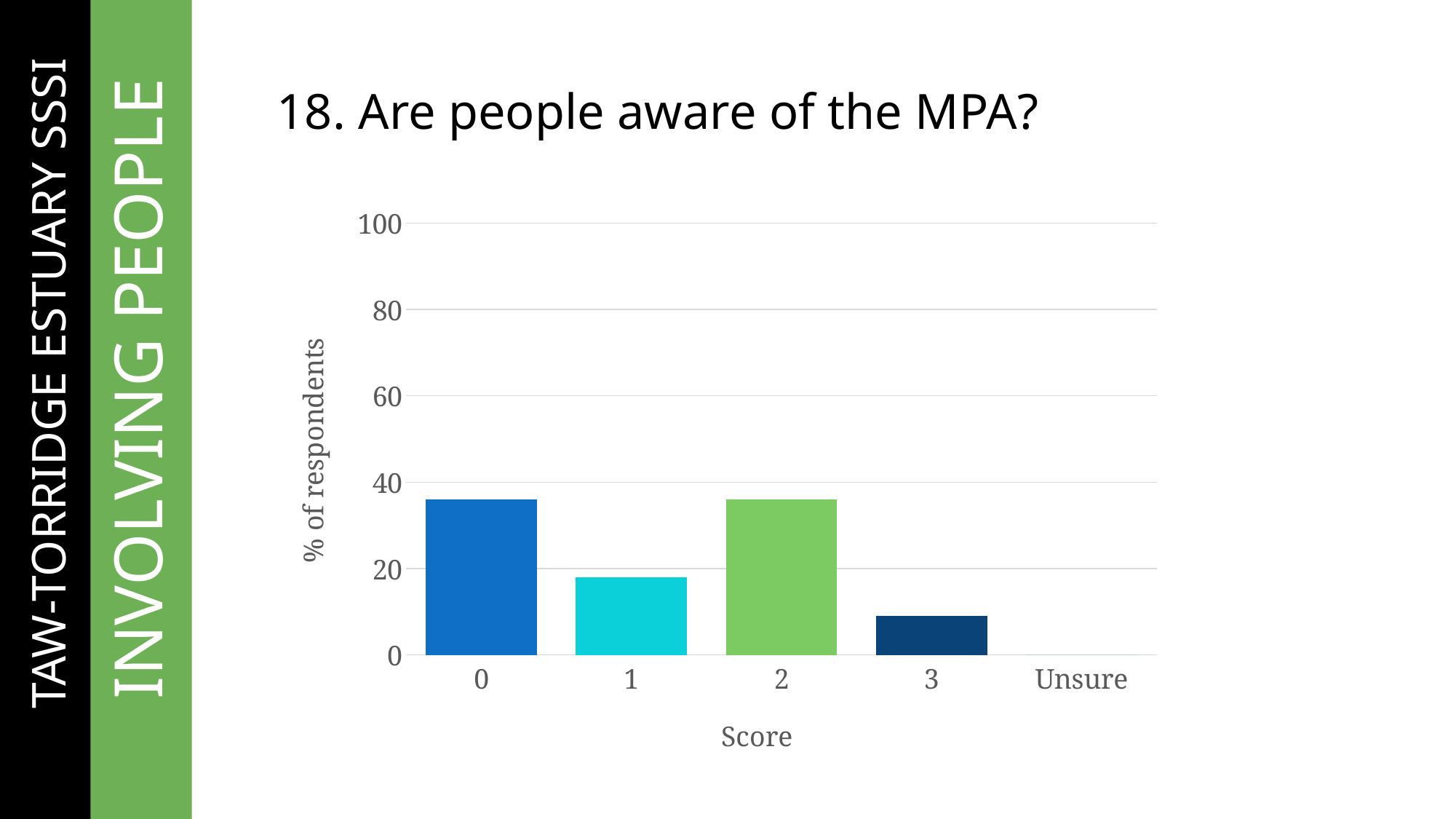
What is the label of the y axis? % of respondents Is the value for score 1 greater or less than 10? greater Which is larger, the value for score 2 or the value for score 3? score 2 How many categories are shown on the x axis of the chart? 5 Which is larger, the value for score 1 or the value for score 3? score 1 What kind of chart is shown on the slide? bar chart Is the value for score 0 greater or less than 20? greater What is the title of the chart? 18. Are people aware of the MPA? Which is larger, the value for score 0 or the value for score 1? score 0 Is the value for score 3 greater or less than 20? less Which category has the lowest value? Unsure